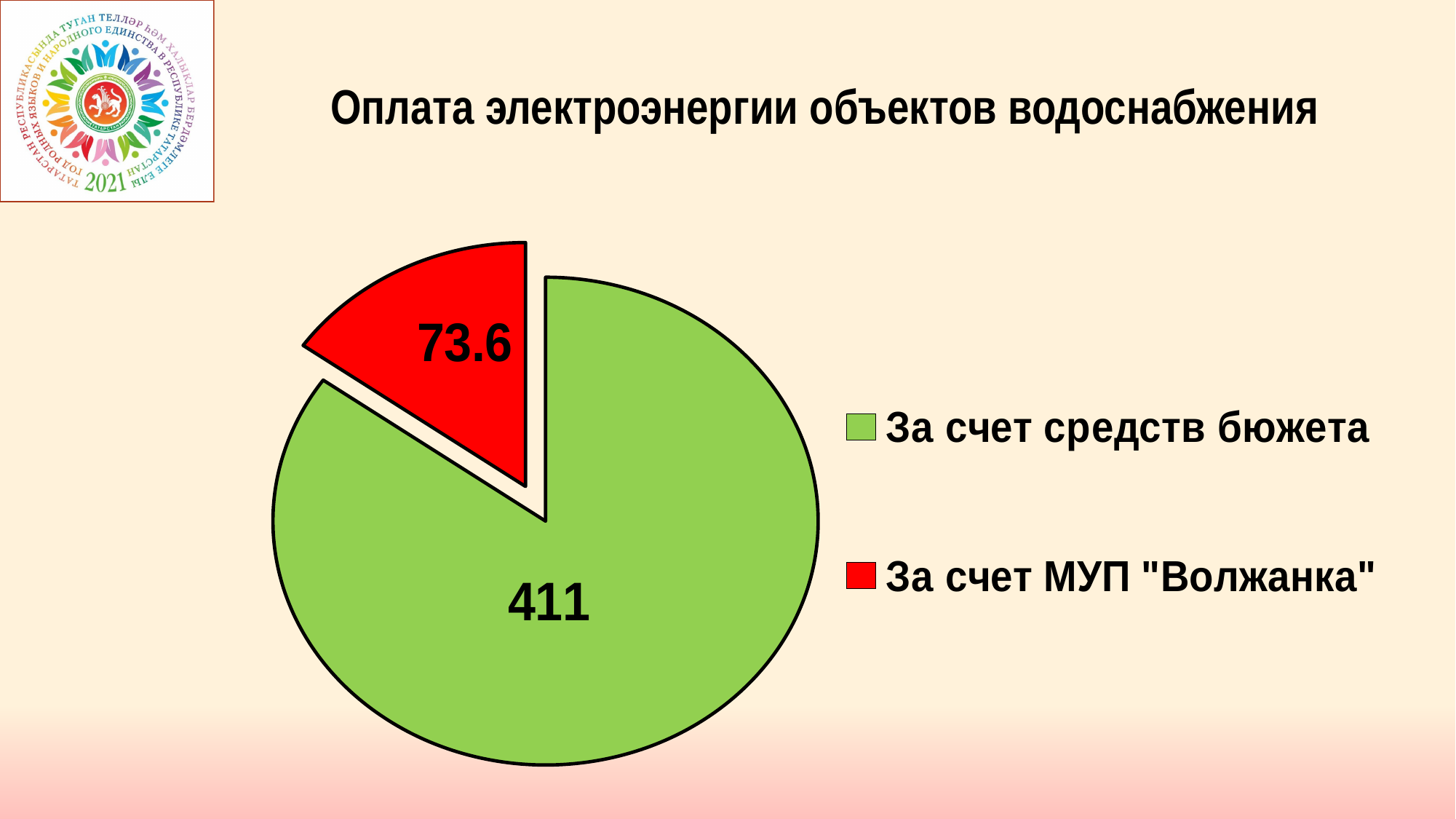
What is the value for "За счет средств бюжета"? 411 What is the total of the two values shown in the pie chart? 484.6 What is the value for "За счет МУП "Волжанка""? 73.6 Which is larger: the value for "За счет средств бюжета" or the value for "За счет МУП "Волжанка""? За счет средств бюжета How many entries does the legend list? 2 What colour is the slice for "За счет МУП "Волжанка""? red Which category has the smallest slice of the pie? За счет МУП "Волжанка" What is the difference between the value for "За счет средств бюжета" and the value for "За счет МУП "Волжанка""? 337.4 What type of chart is shown on the slide? pie chart How many slices does the pie chart have? 2 What is the title of the chart? Оплата электроэнергии объектов водоснабжения Which category has the largest slice of the pie? За счет средств бюжета